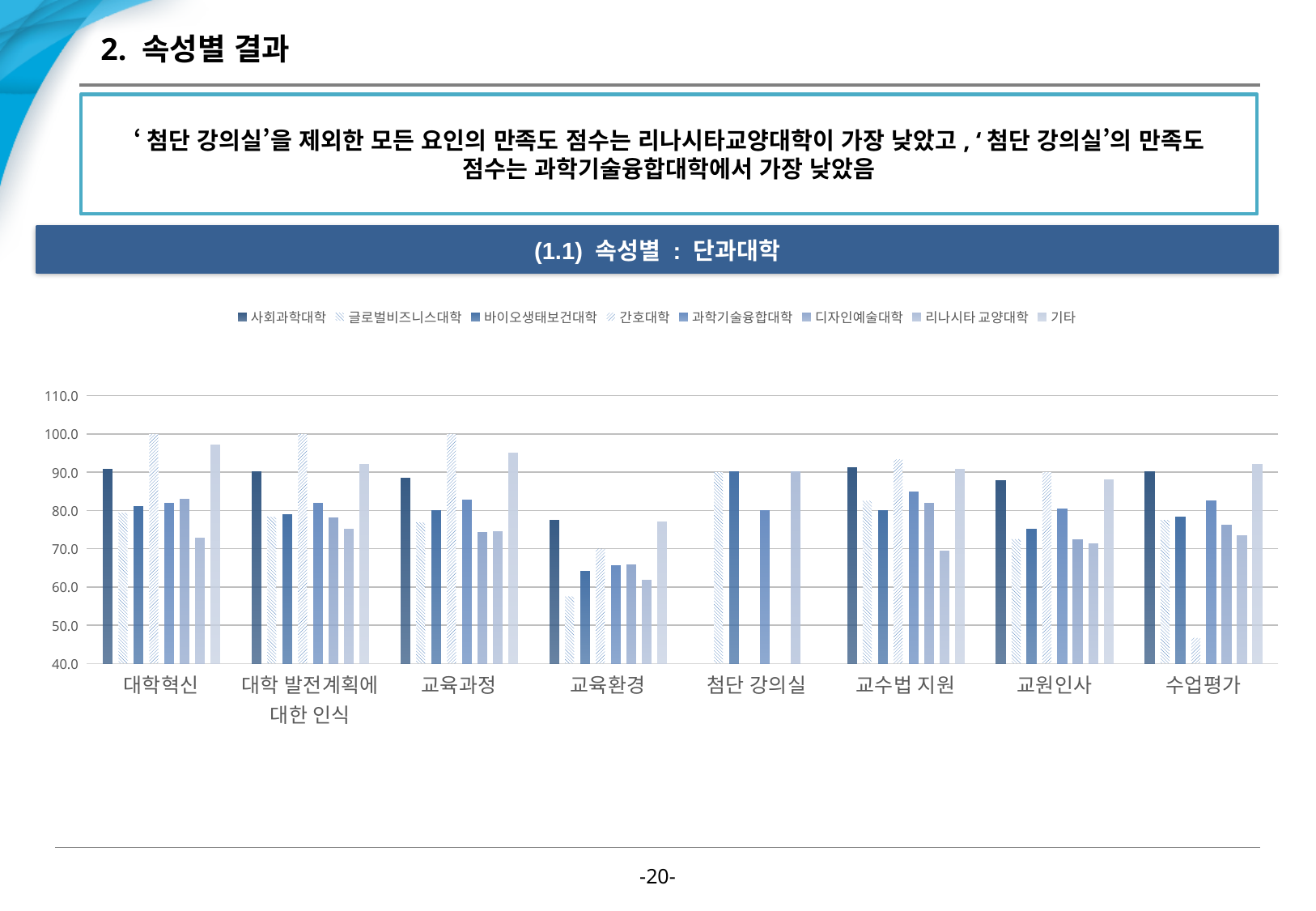
Is the value for 기타 in the 교육과정 category greater or less than 90? greater Is the value for 기타 in the 대학혁신 category greater or less than 90? greater Is the value for 리나시타 교양대학 in the 수업평가 category greater or less than 50? greater In the 교육환경 category, which series has the lowest value? 글로벌비즈니스대학 How many series does the chart legend list? 8 What kind of chart is shown on the slide? bar chart In the 교육환경 category, which is larger: the value for 사회과학대학 or the value for 바이오생태보건대학? 사회과학대학 How many categories are shown on the x axis of the chart? 8 In the 수업평가 category, which series has the lowest value? 간호대학 What is the title shown in the banner above the chart? (1.1) 속성별 : 단과대학